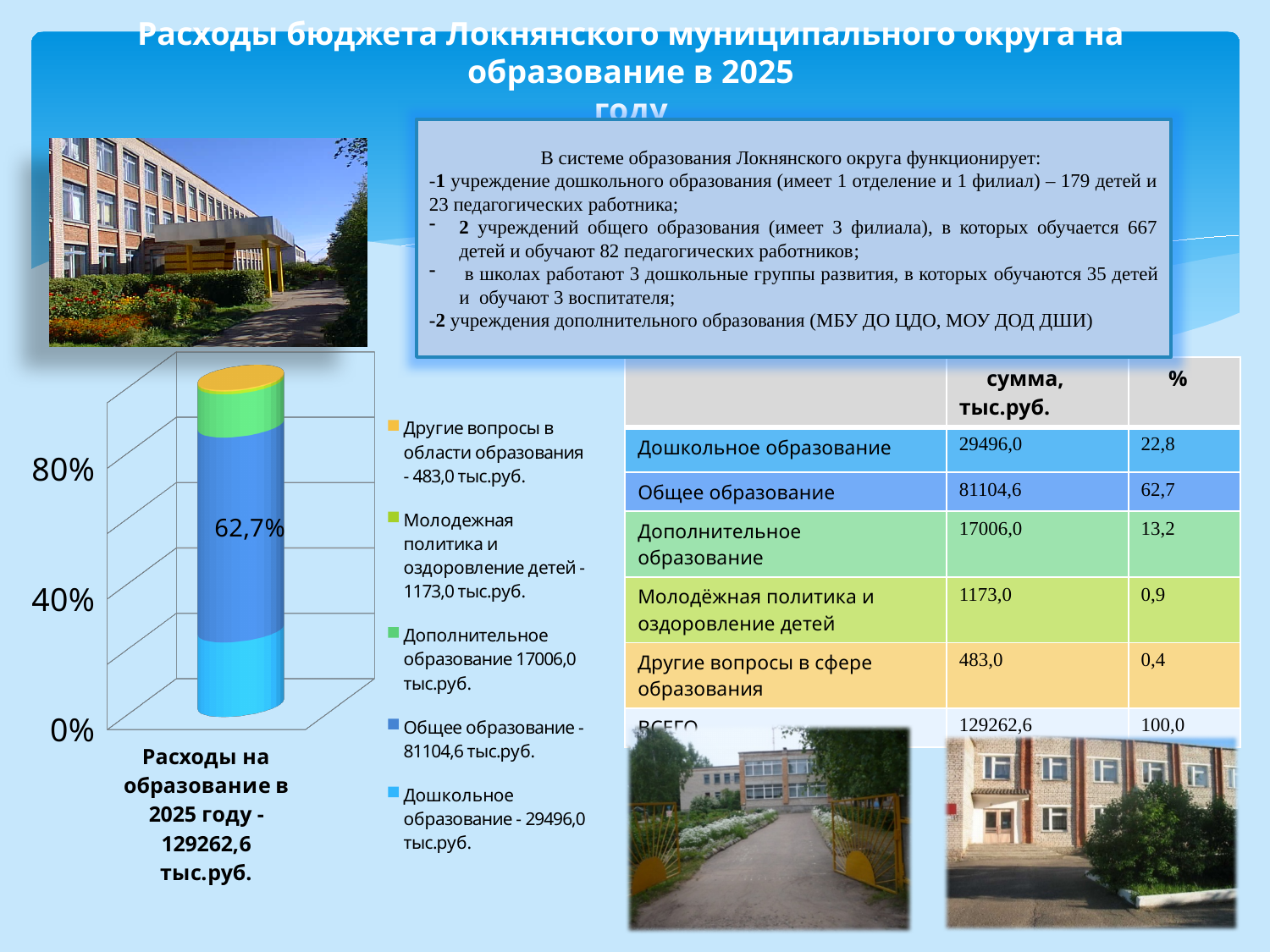
According to the chart legend, what is the amount for Дополнительное образование? 17006,0 тыс.руб. Which series makes up the largest segment of the bar? Общее образование Is the Дошкольное образование segment of the bar greater or less than 40%? less How many bars (categories) does the chart show? 1 What percentage is printed on the Общее образование segment of the bar? 62,7% What type of chart is shown on the left of the slide? Stacked bar chart What is the total of the stacked bar, as given in the category label under the chart? 129262,6 тыс.руб. Which series makes up the smallest segment of the bar? Другие вопросы в области образования How many series does the legend of the bar chart list? 5 What is the difference between the legend amounts for Общее образование and Дошкольное образование? 51608,6 тыс.руб. Which is larger according to the chart legend: Общее образование or Дошкольное образование? Общее образование According to the chart legend, what is the amount for Молодежная политика и оздоровление детей? 1173,0 тыс.руб.